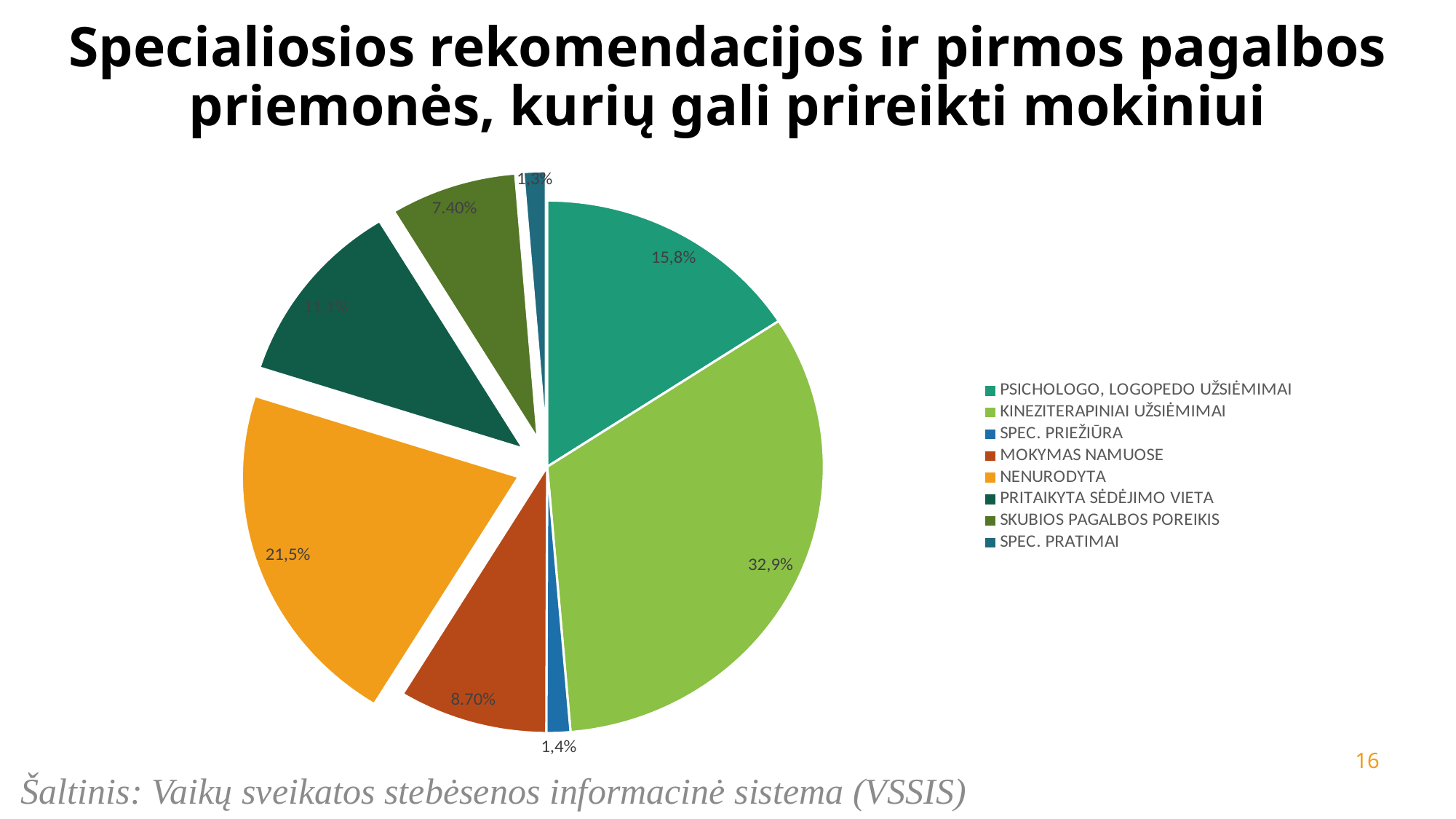
Which category has the largest share of the pie? KINEZITERAPINIAI UŽSIĖMIMAI What percentage is shown for KINEZITERAPINIAI UŽSIĖMIMAI? 32,9% What percentage is shown for SPEC. PRIEŽIŪRA? 1,4% What type of chart is shown on the slide? Pie chart What percentage is shown for SKUBIOS PAGALBOS POREIKIS? 7.40% How many categories does the legend list? 8 What colour is the NENURODYTA slice? Orange What percentage is shown for NENURODYTA? 21,5% What is the difference in percentage points between KINEZITERAPINIAI UŽSIĖMIMAI and NENURODYTA? 11,4 What percentage is shown for PSICHOLOGO, LOGOPEDO UŽSIĖMIMAI? 15,8% What percentage is shown for MOKYMAS NAMUOSE? 8.70% Which is larger: the share for NENURODYTA or the share for PSICHOLOGO, LOGOPEDO UŽSIĖMIMAI? NENURODYTA